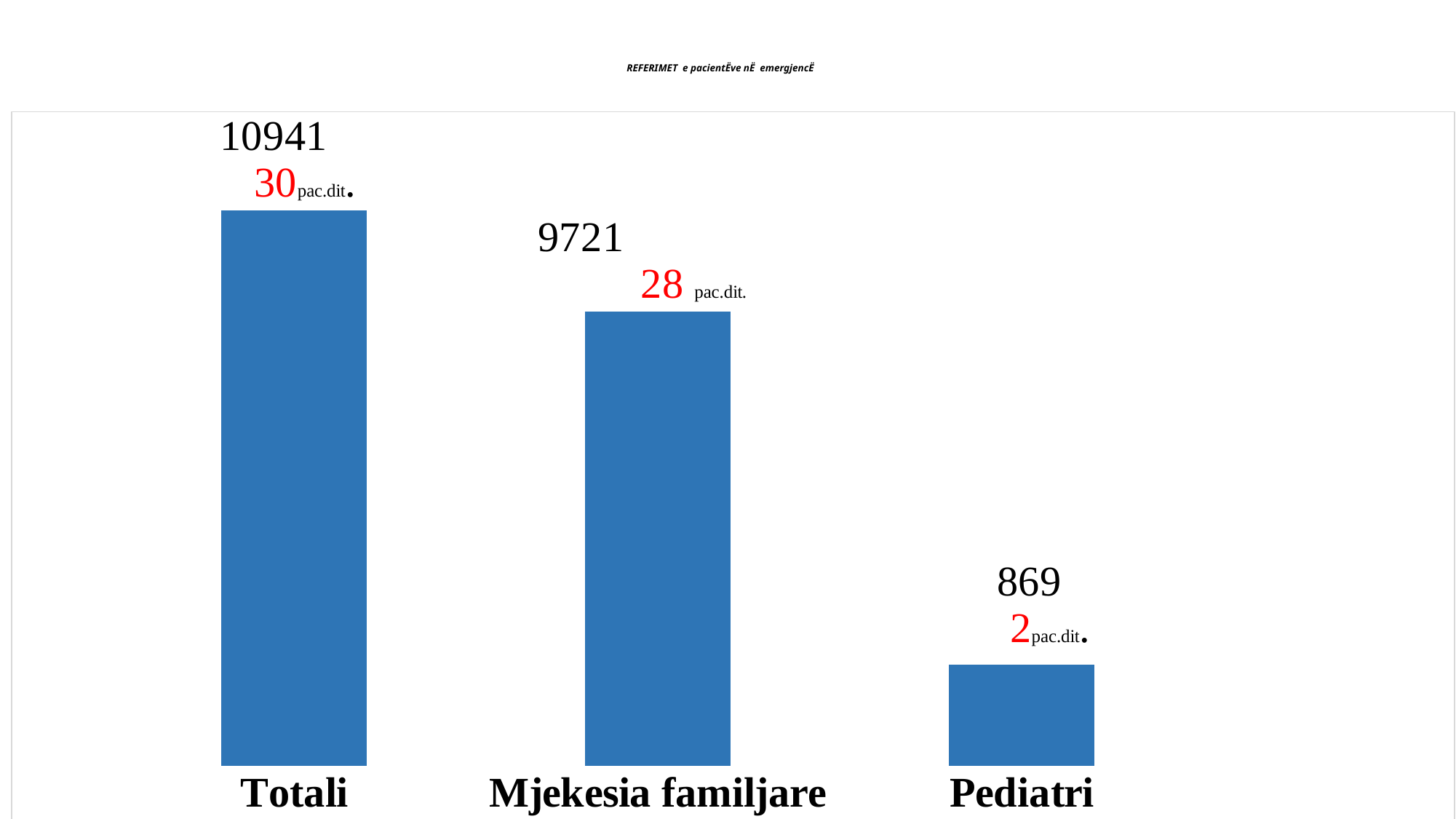
Which category has the lowest value? Pediatri What is the title of the chart? REFERIMET e pacientËve nË emergjencË How many categories are shown in the chart? 3 What is the difference between the values for Mjekesia familjare and Pediatri? 8852 What is the value for Pediatri? 869 Which category has the highest value? Totali What is the difference between the values for Totali and Mjekesia familjare? 1220 Which is larger, the value for Mjekesia familjare or the value for Pediatri? Mjekesia familjare What is the value for Mjekesia familjare? 9721 How many patients per day (pac.dit.) are shown in red for Mjekesia familjare? 28 What is the value for Totali? 10941 What kind of chart is shown on the slide? bar chart